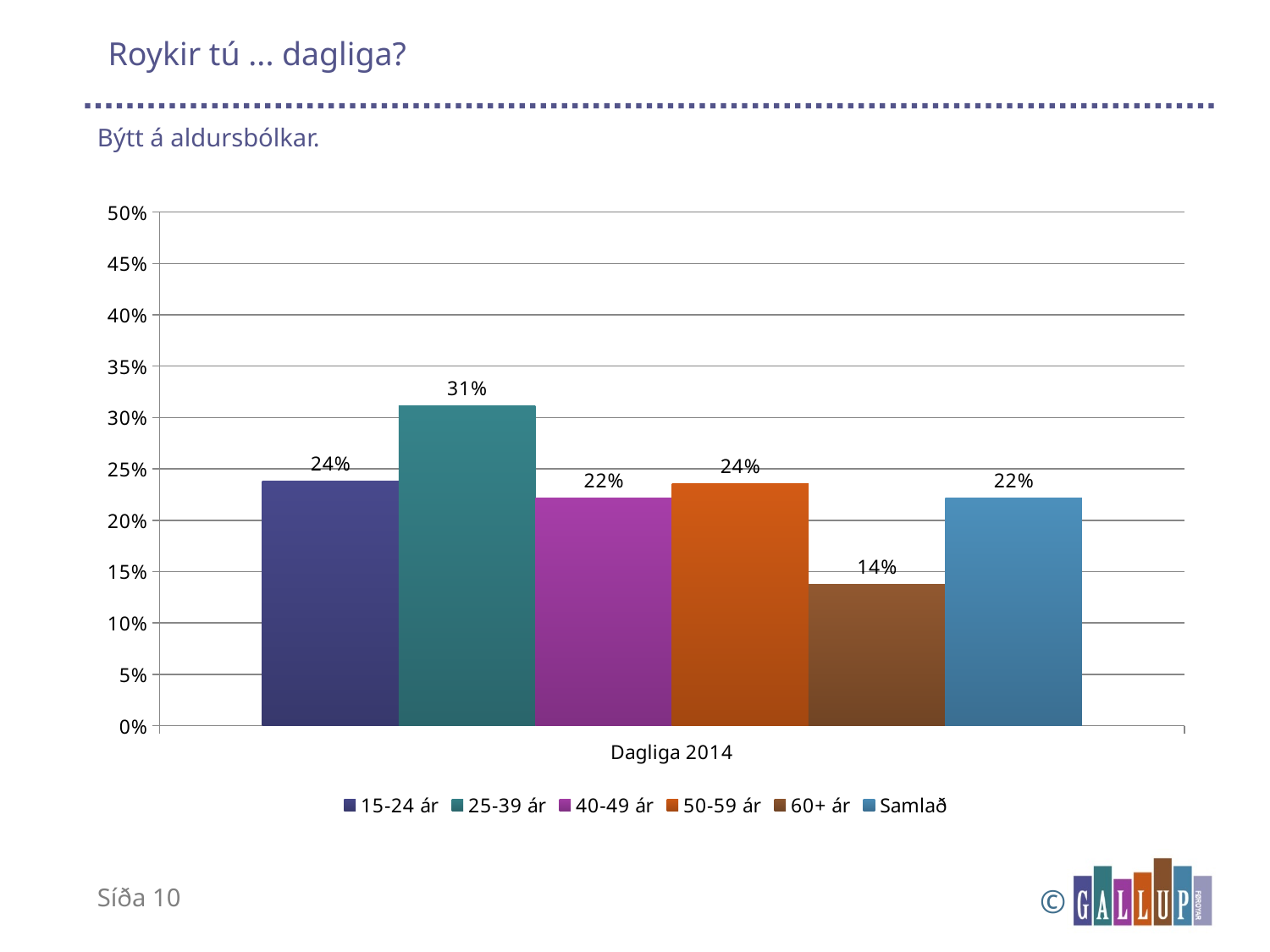
What kind of chart is shown on the slide? bar chart Which age group has the lowest value? 60+ ár Which is larger, the value for 40-49 ár or the value for 60+ ár? 40-49 ár What is the difference between the values for 25-39 ár and 60+ ár? 17% What is the difference between the values for 25-39 ár and Samlað? 9% What is the value for the 15-24 ár series? 24% What is the value for the 60+ ár series? 14% What is the value for the 25-39 ár series? 31% How many series does the legend list? 6 Which age group has the highest value? 25-39 ár What is the value for the Samlað series? 22% Is the value for 25-39 ár greater or less than 30%? greater